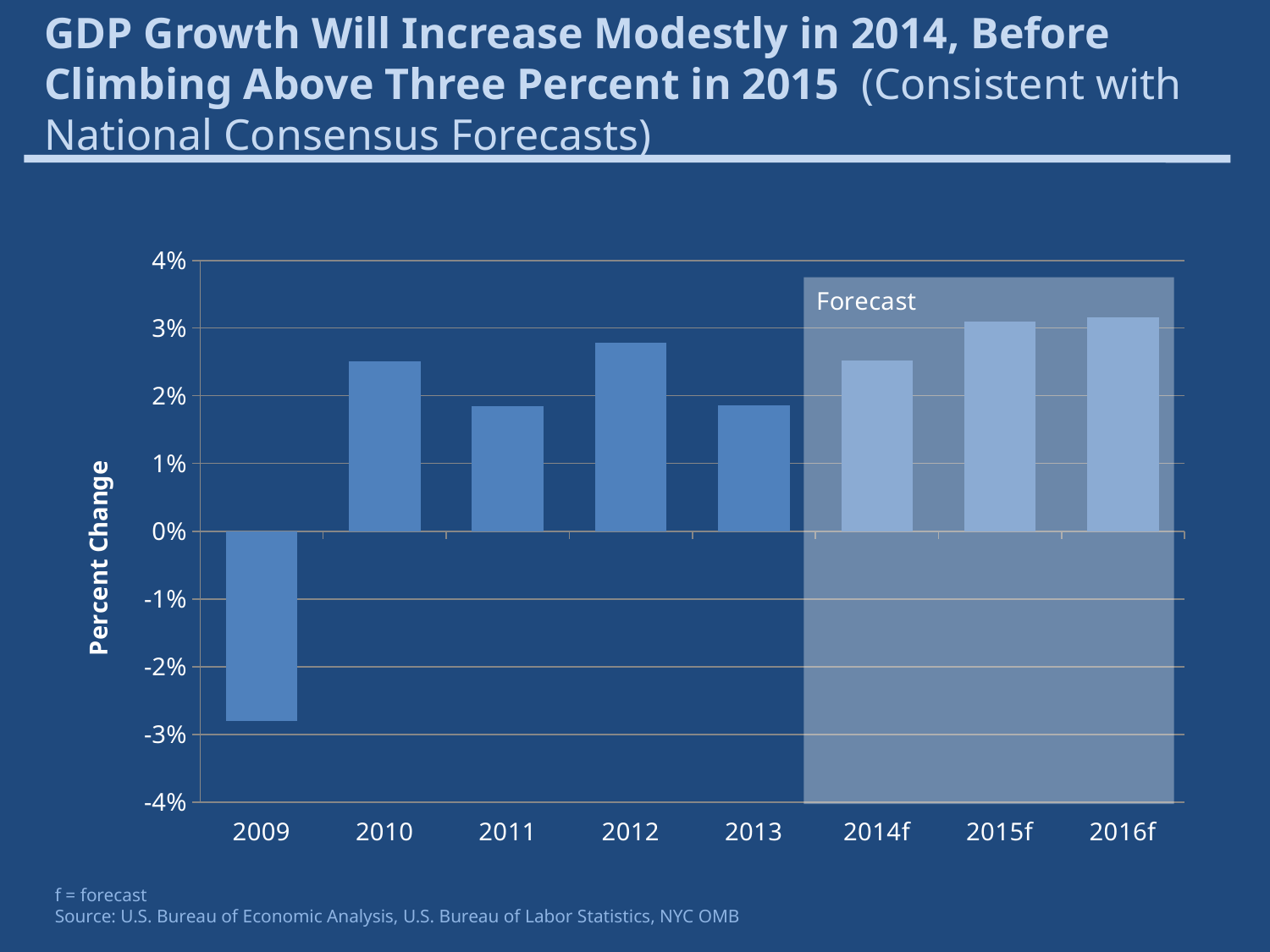
Which year has the lowest GDP growth value in the chart? 2009 Is the value for 2009 greater or less than -2%? less Is the value for 2011 greater or less than 2%? less Is the value for 2013 greater or less than 1%? greater Do the values rise or fall across the forecast years from 2014f to 2016f? rise What kind of chart is shown on the slide? bar chart Which is larger, the value for 2012 or the value for 2011? 2012 What is the label on the vertical axis of the chart? Percent Change Which is larger, the value for 2015f or the value for 2014f? 2015f How many years are shown on the x axis of the chart? 8